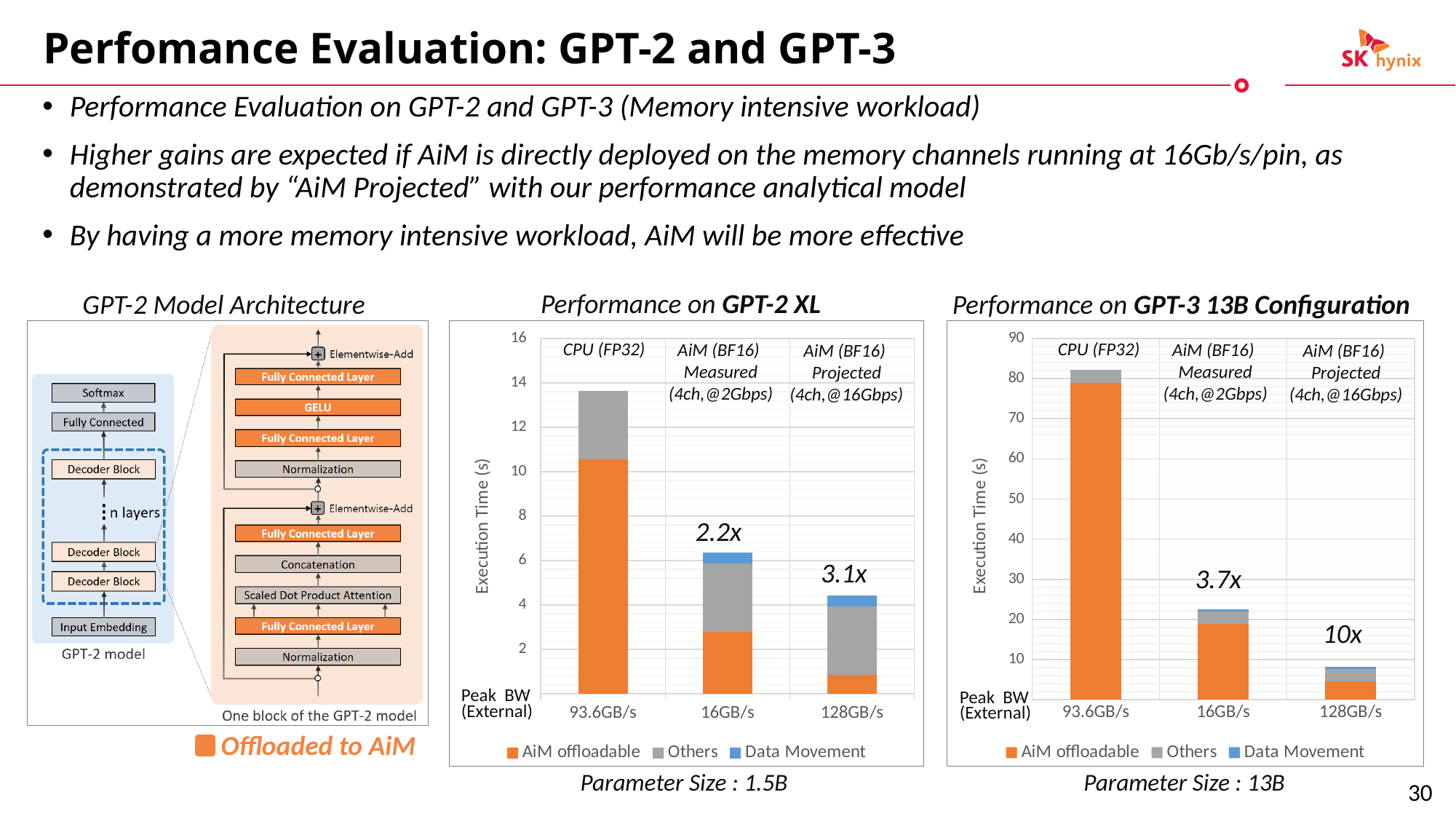
In the "Performance on GPT-2 XL" chart, is the total execution time for the CPU (FP32) bar greater or less than 12? greater In the "Performance on GPT-3 13B Configuration" chart, what speedup is annotated above the 128GB/s bar? 10x In the "Performance on GPT-3 13B Configuration" chart, which series is shown in orange? AiM offloadable In the "Performance on GPT-2 XL" chart, which peak bandwidth category has the shortest bar? 128GB/s In the "Performance on GPT-3 13B Configuration" chart, is the total execution time for the CPU (FP32) bar greater or less than 70? greater In the "Performance on GPT-2 XL" chart, which peak bandwidth category has the tallest bar? 93.6GB/s In the "Performance on GPT-3 13B Configuration" chart, what speedup is annotated above the AiM (BF16) Measured bar? 3.7x In the "Performance on GPT-2 XL" chart, what speedup is annotated above the AiM (BF16) Projected bar? 3.1x In the "Performance on GPT-3 13B Configuration" chart, how many bars are plotted? 3 What kind of chart is "Performance on GPT-2 XL"? Stacked bar chart In the "Performance on GPT-2 XL" chart, how many series does the legend list? 3 In the "Performance on GPT-2 XL" chart, is the total execution time for the 128GB/s bar greater or less than 6? less